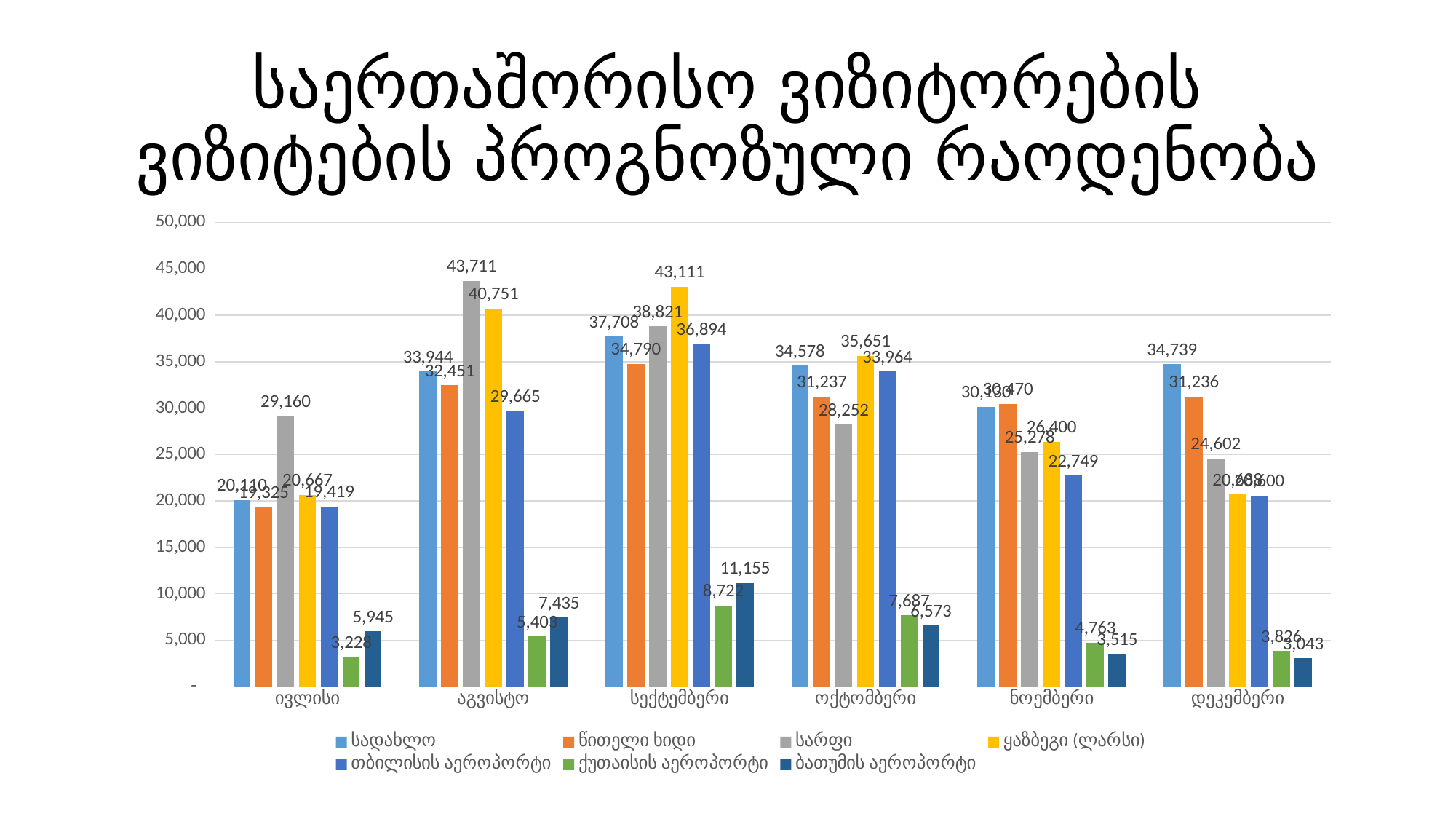
Which series has the highest value in ოქტომბერი? ყაზბეგი (ლარსი) How many month categories are shown on the x axis? 6 How many series does the legend list? 7 Which series has the lowest value in ნოემბერი? ბათუმის აეროპორტი What is the value for სარფი in აგვისტო? 43,711 Is the value for თბილისის აეროპორტი in აგვისტო greater or less than 25,000? greater Does the value for ქუთაისის აეროპორტი rise or fall from სექტემბერი to დეკემბერი? fall What is the value for ბათუმის აეროპორტი in ივლისი? 5,945 What type of chart is shown on the slide? bar chart What is the value for ყაზბეგი (ლარსი) in სექტემბერი? 43,111 What is the difference between სარფი and სადახლო in ივლისი? 9,050 Which is larger in სექტემბერი: სადახლო or წითელი ხიდი? სადახლო